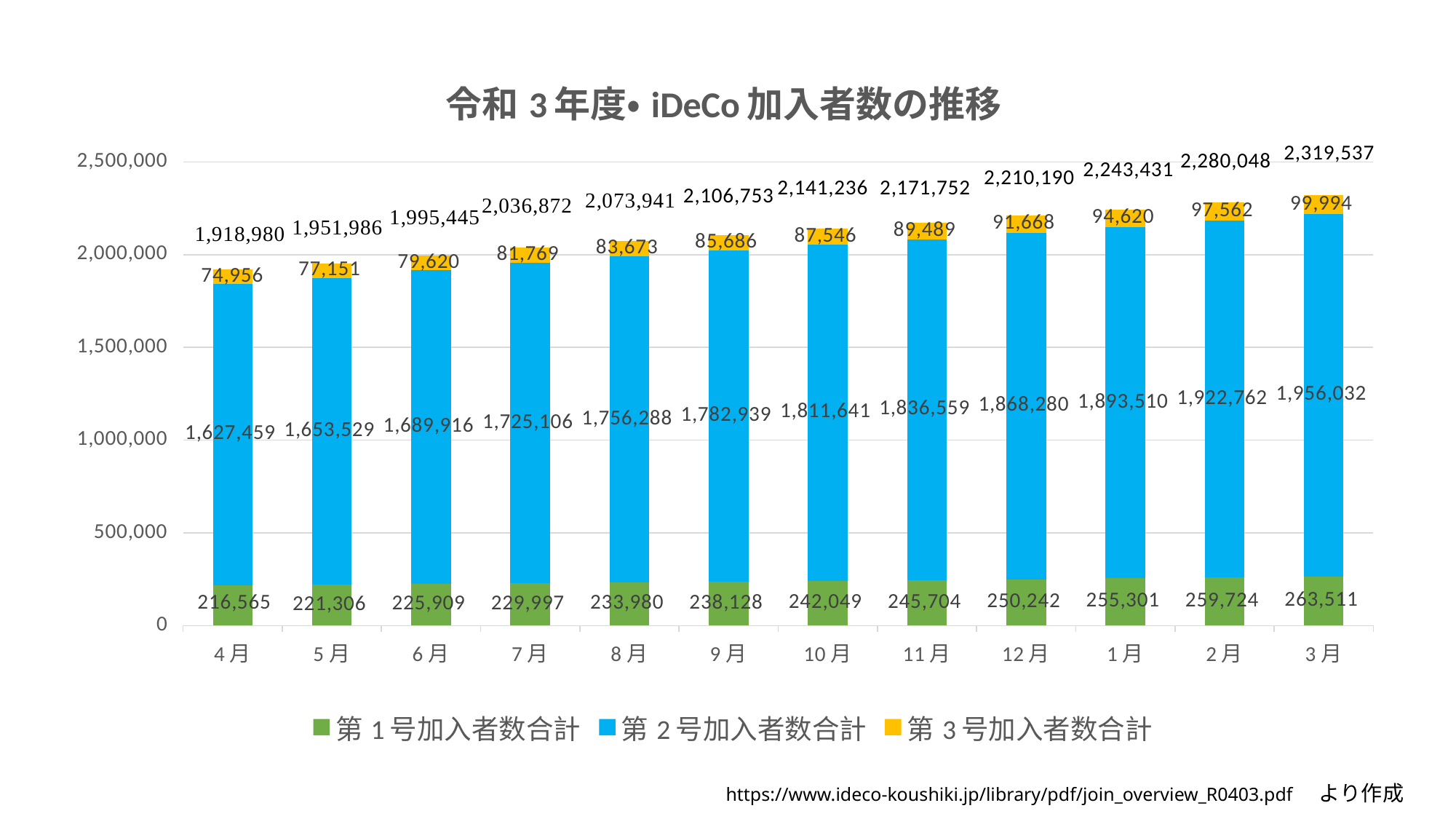
Which month has the lowest value for 第１号加入者数合計? 4月 What is the value of 第１号加入者数合計 for 12月? 250,242 How many months are shown on the x axis? 12 Which is larger, the 第３号加入者数合計 value for 7月 or for 11月? 11月 What type of chart is shown on the slide? Stacked bar chart What is the total number of subscribers shown for 9月? 2,106,753 How many series does the legend list? 3 What is the difference between the 第２号加入者数合計 values for 3月 and 4月? 328,573 Which month has the highest total number of subscribers? 3月 Do the total subscriber numbers rise or fall from 4月 to 3月? Rise What is the value of 第２号加入者数合計 for 4月? 1,627,459 What is the value of 第３号加入者数合計 for 3月? 99,994